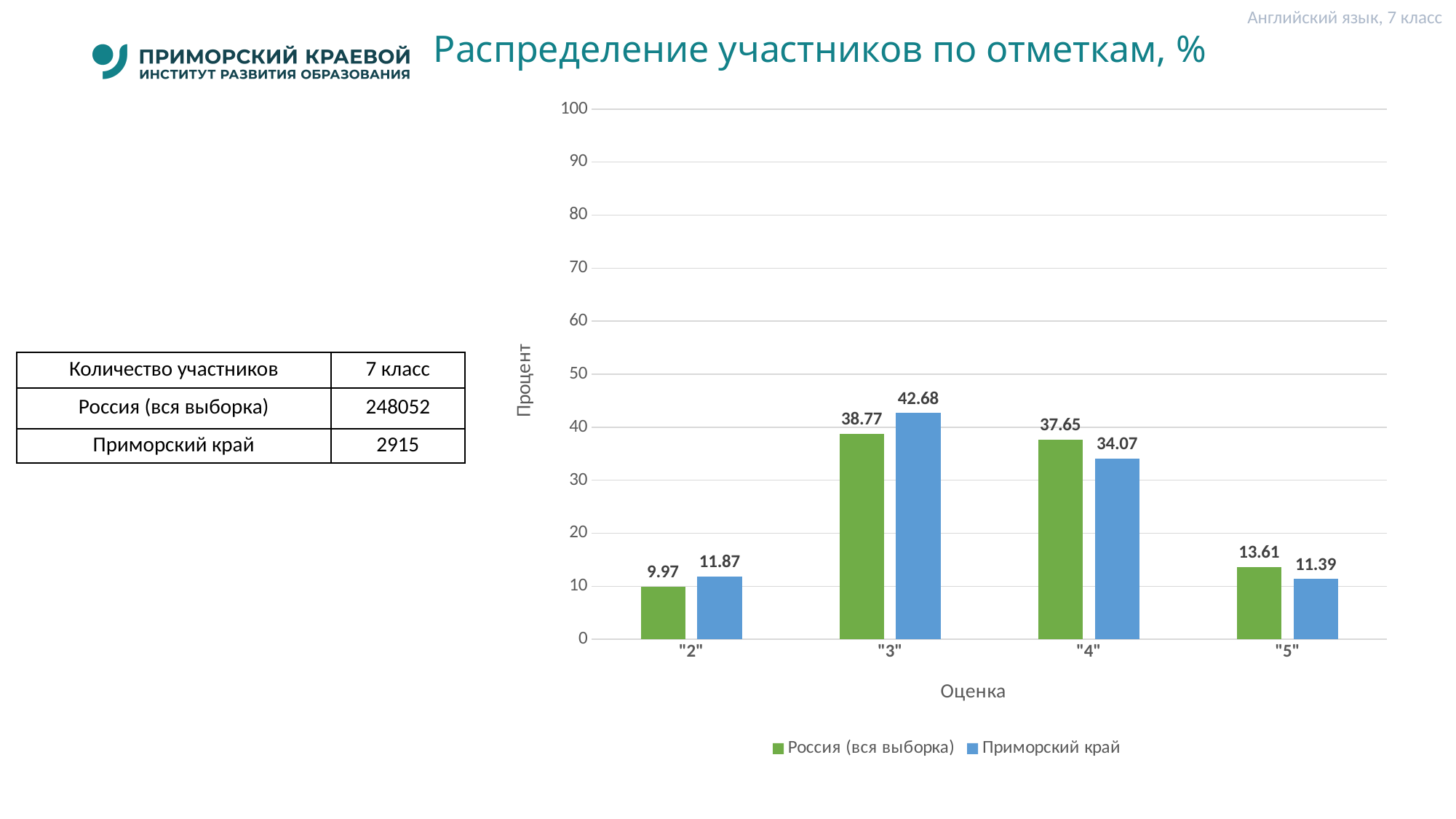
Which grade has the lowest value for Россия (вся выборка)? "2" What is the value for Приморский край at grade "2"? 11.87 How many grade categories are shown on the x axis? 4 What is the label of the y axis? Процент What is the difference between Приморский край and Россия (вся выборка) at grade "3"? 3.91 Which series has the larger value at grade "4"? Россия (вся выборка) Which grade has the highest value for Приморский край? "3" What is the value for Приморский край at grade "4"? 34.07 What is the value for Россия (вся выборка) at grade "3"? 38.77 How many series does the legend list? 2 What is the value for Россия (вся выборка) at grade "5"? 13.61 What kind of chart is shown on the slide? bar chart